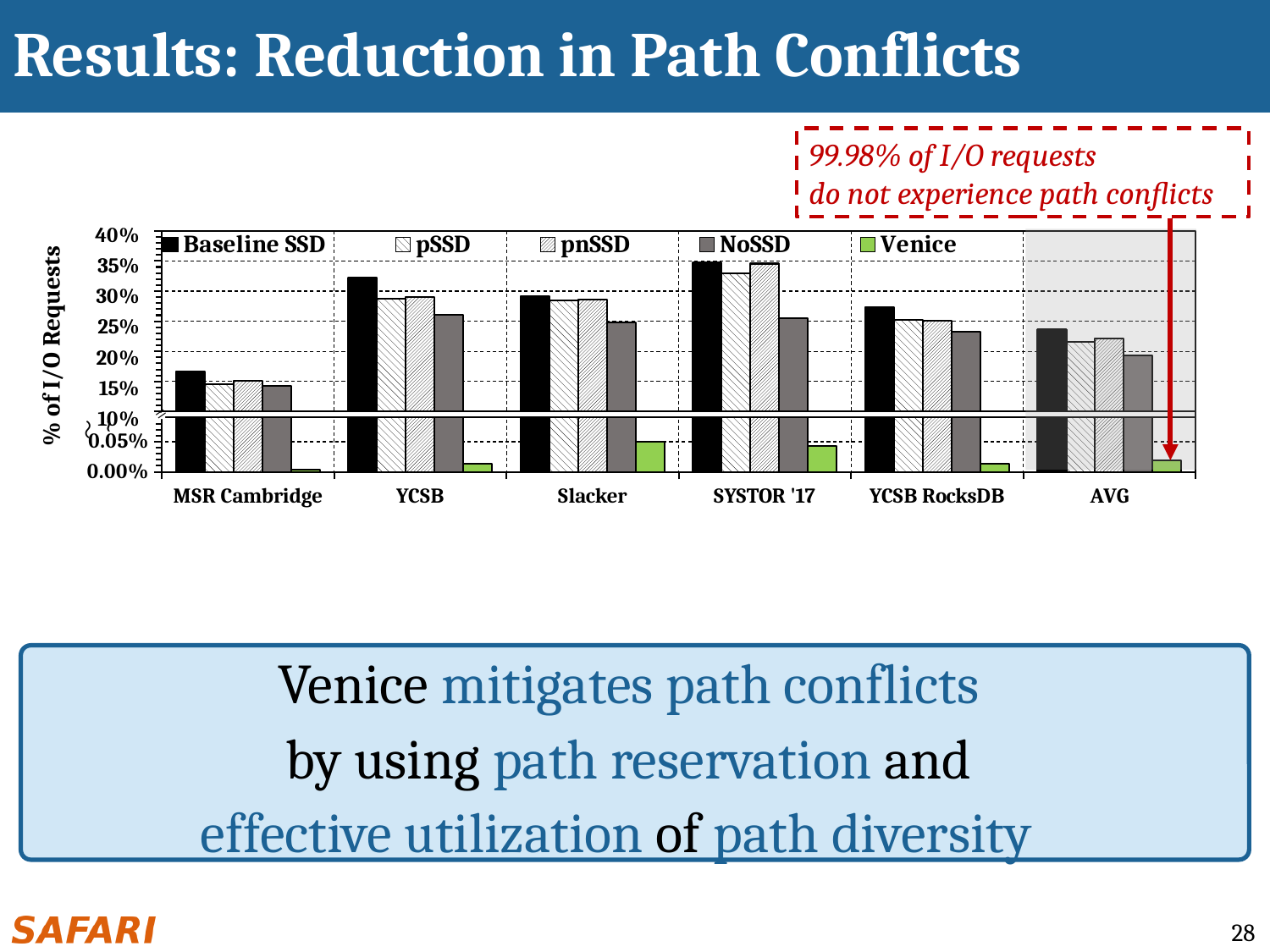
How many workload categories are shown along the x axis of the chart? 6 What is the label of the chart's y axis? % of I/O Requests For Slacker, which is larger: the Venice value or the Baseline SSD value? Baseline SSD Which series has the lowest value for every workload in the chart? Venice Is the Baseline SSD value for YCSB greater or less than 30%? greater Is the Baseline SSD value for YCSB RocksDB greater or less than 25%? greater What kind of chart is shown on the slide? bar chart Which workload has the lowest Baseline SSD value? MSR Cambridge For YCSB, which is larger: the Baseline SSD value or the NoSSD value? Baseline SSD Is the Baseline SSD value for MSR Cambridge greater or less than 20%? less Which workload has the highest Baseline SSD value? SYSTOR '17 How many series does the chart's legend list? 5